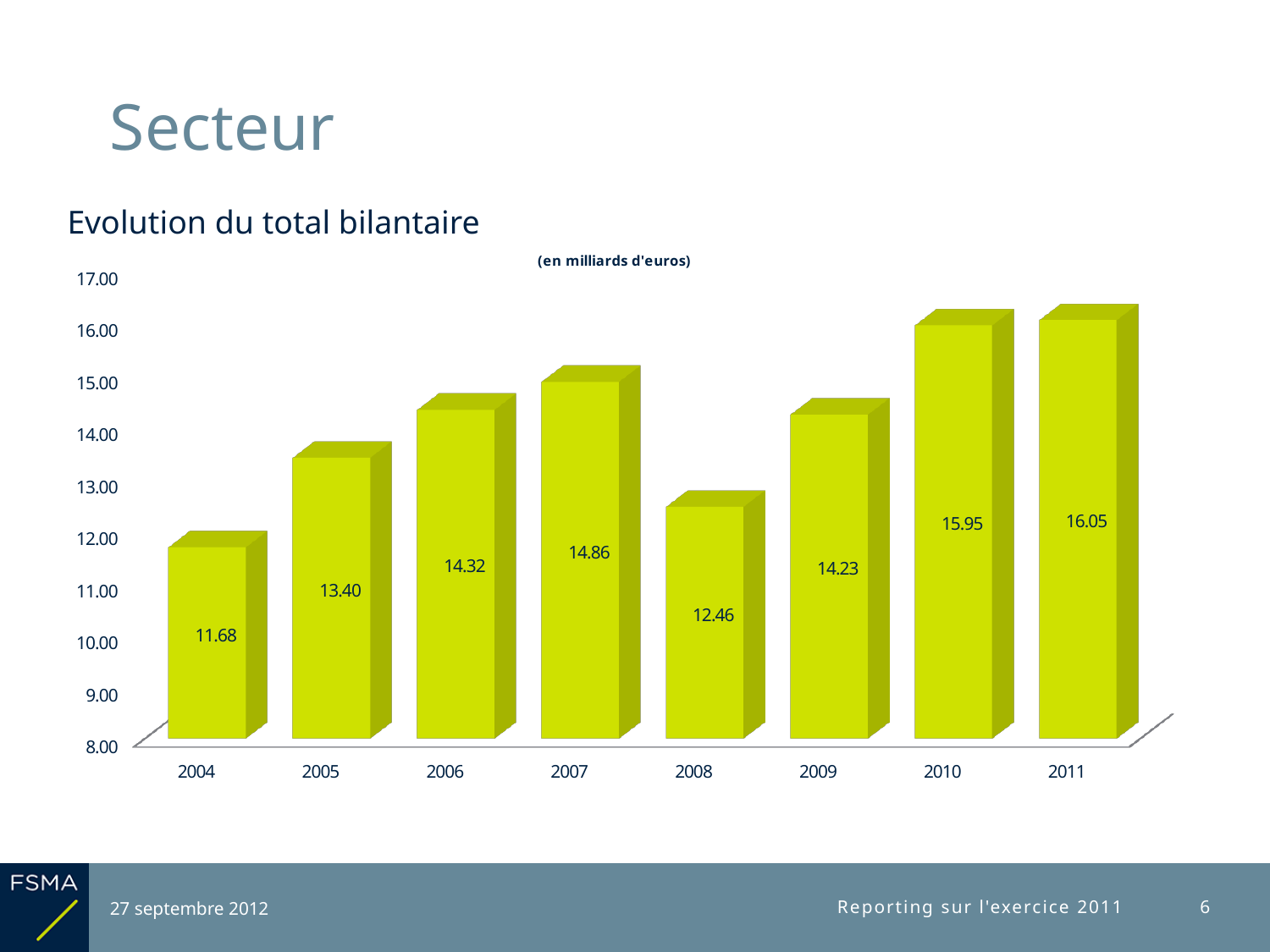
What is the difference between the values for 2011 and 2004? 4.37 Which year has the lowest value? 2004 What is the value for 2008? 12.46 What is the value for 2011? 16.05 What is the difference between the values for 2007 and 2008? 2.40 What is the value for 2004? 11.68 How many years are shown on the chart? 8 What unit is stated for the chart's values? en milliards d'euros Which year has the highest value? 2011 What kind of chart is shown? bar chart Is the value for 2010 greater or less than 15.00? greater Which is larger, the value for 2006 or the value for 2009? 2006